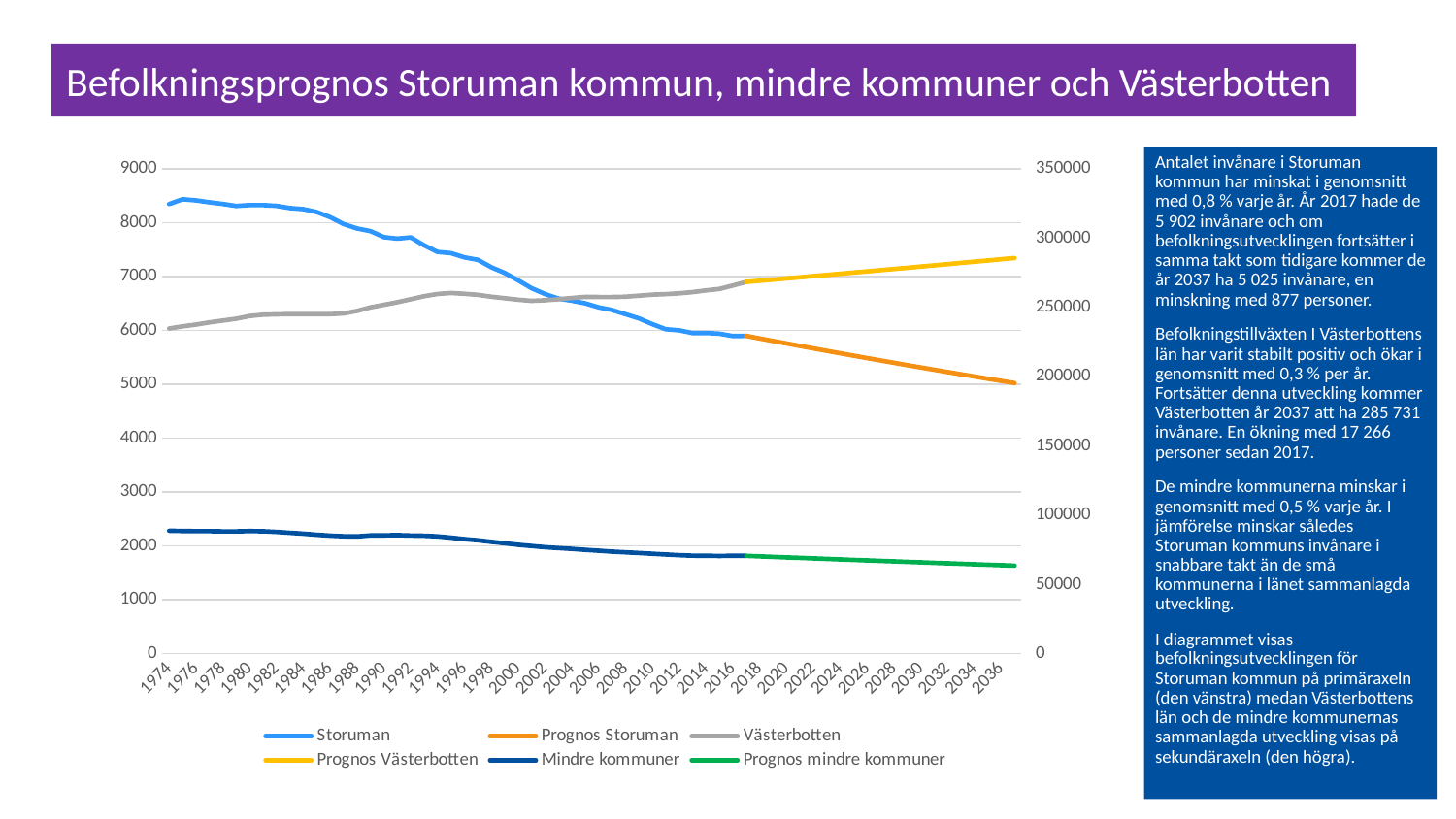
Does the Prognos Västerbotten series rise or fall from 2018 to 2036? rise Is the value for Prognos Storuman in 2036 greater or less than 6000 on the left axis? less Does the Storuman series rise or fall from 1974 to 2016? fall How many series does the legend list? 6 Is the value for Prognos Västerbotten in 2036 greater or less than 250000 on the right axis? greater What colour is the Prognos Storuman line in the legend? orange What is the title of the slide containing the chart? Befolkningsprognos Storuman kommun, mindre kommuner och Västerbotten Is the value for Storuman in 1974 greater or less than 8000 on the left axis? greater What kind of chart is shown on the slide? line chart How many year labels are shown on the x axis? 32 Is the value for Storuman in 1974 larger or smaller than the value for Storuman in 2016? larger Does the Mindre kommuner series rise or fall from 1974 to 2016? fall